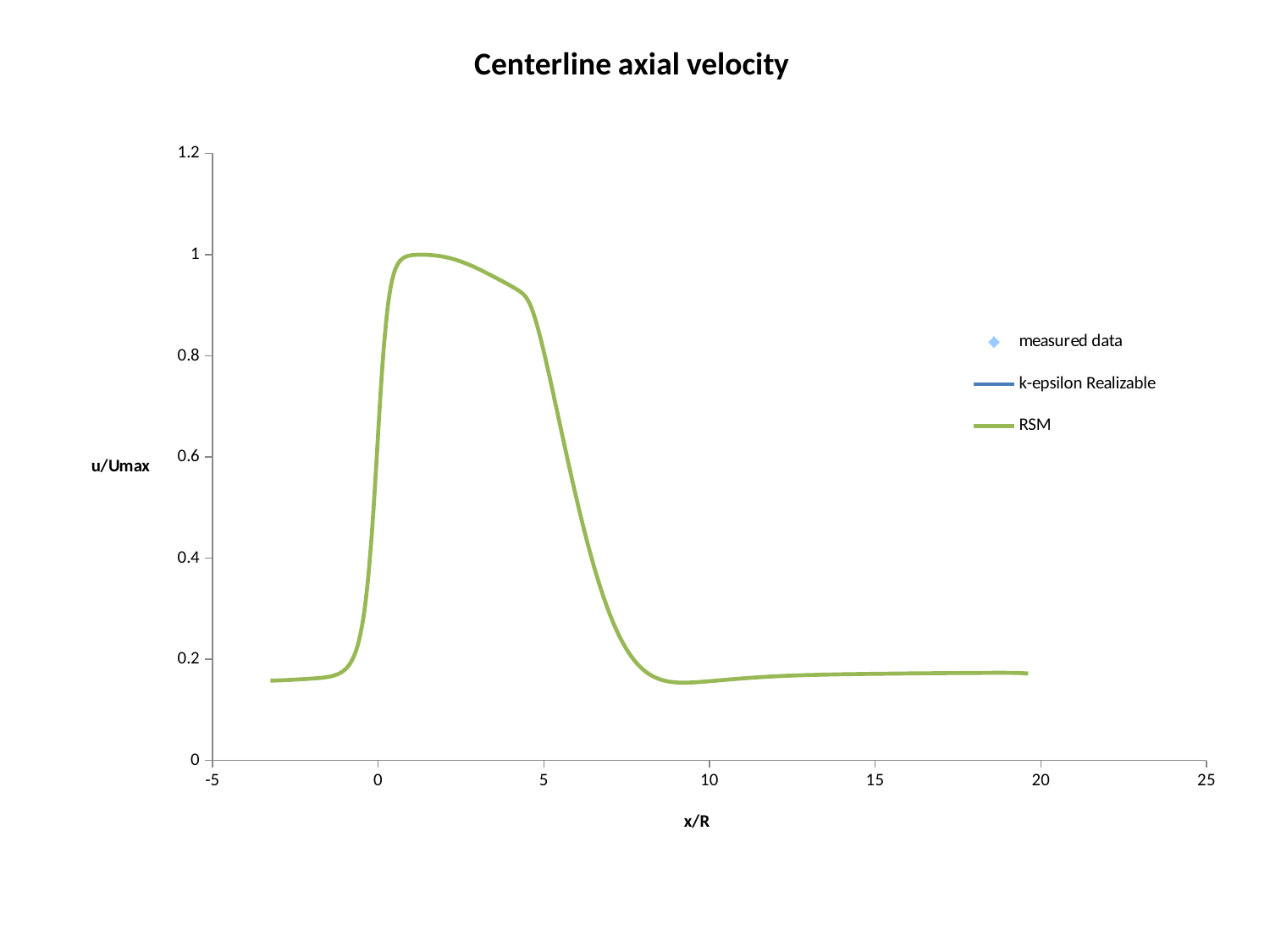
Does u/Umax rise or fall between x/R = -1 and x/R = 1? rise Does u/Umax rise or fall between x/R = 5 and x/R = 10? fall How many series does the legend list? 3 What label is shown on the x axis? x/R Is the value of u/Umax at x/R = 10 greater or less than 0.2? less What is the title of the chart? Centerline axial velocity What kind of chart is shown on the slide? line chart Is u/Umax larger at x/R = 2 or at x/R = 15? x/R = 2 Is the peak value of u/Umax greater or less than 0.8? greater